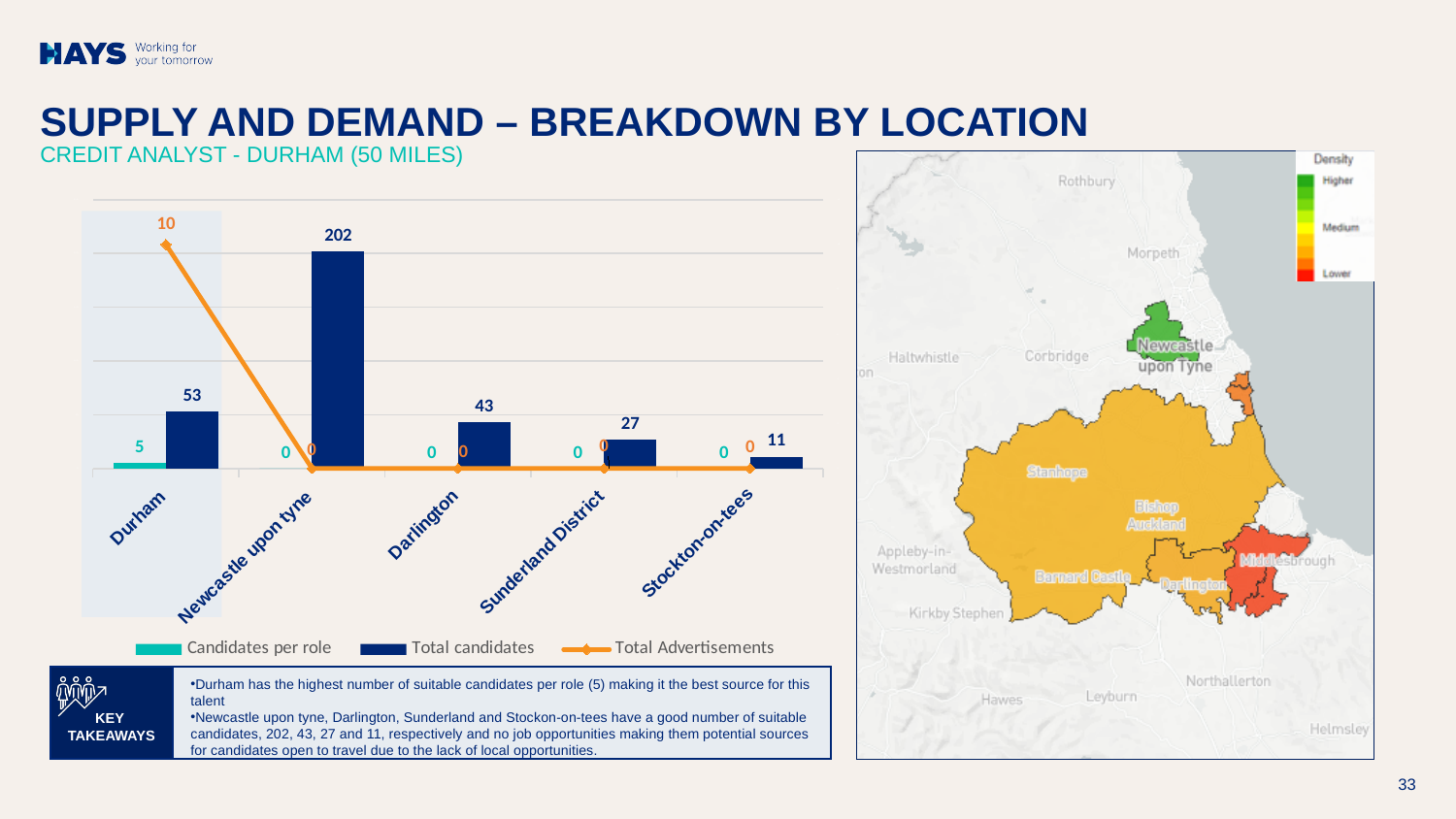
Which has a larger Total candidates value, Darlington or Sunderland District? Darlington What is the Total candidates value for Newcastle upon tyne? 202 How many locations are shown on the x axis of the chart? 5 How many series does the chart legend list? 3 What is the Total candidates value for Stockton-on-tees? 11 Which series in the chart is drawn as a line rather than bars? Total Advertisements Which location has the lowest Total candidates value? Stockton-on-tees What is the Total Advertisements value for Durham? 10 Which location has the highest Total candidates value? Newcastle upon tyne What is the difference between the Total candidates values for Newcastle upon tyne and Darlington? 159 What is the Total candidates value for Durham? 53 What is the Candidates per role value for Durham? 5